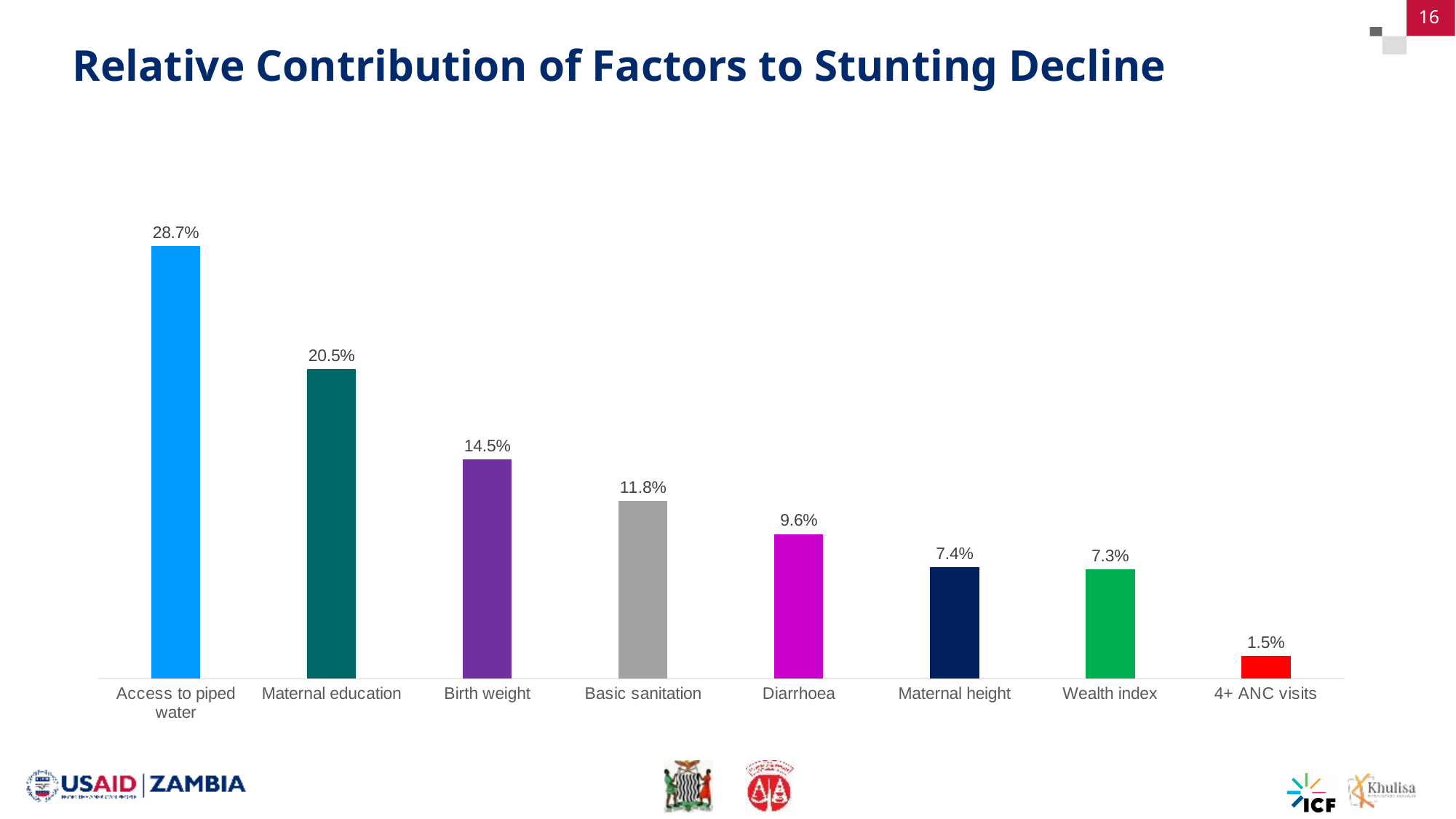
What is the relative contribution of Access to piped water to stunting decline? 28.7% Do the values rise or fall from left to right along the x axis? Fall What is the difference between the values for Birth weight and Basic sanitation? 2.7% What kind of chart is shown on the slide? Bar chart What is the value shown for 4+ ANC visits? 1.5% Which is larger, the value for Basic sanitation or the value for Diarrhoea? Basic sanitation What is the value for Diarrhoea? 9.6% Which factor has the highest relative contribution? Access to piped water What is the difference between the values for Access to piped water and Maternal education? 8.2% What value is shown for Maternal education? 20.5% Which factor has the lowest relative contribution? 4+ ANC visits How many factors are shown in the chart? 8